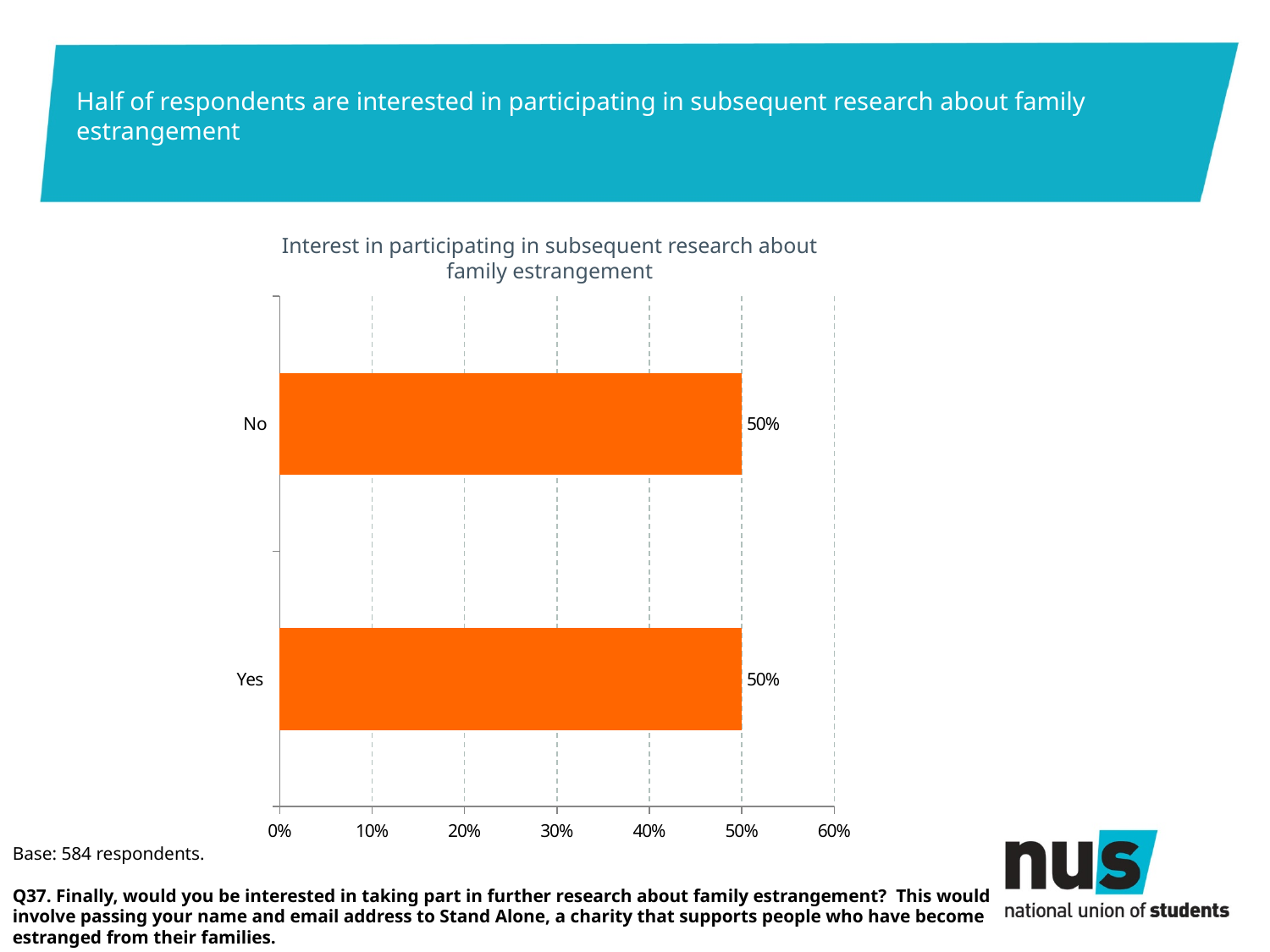
Is the value for "Yes" greater or less than 40%? greater What is the highest value shown on the x axis? 60% What kind of chart is shown on the slide? Bar chart What is the value for "No"? 50% What is the value for "Yes"? 50% What is the title of the chart? Interest in participating in subsequent research about family estrangement How many categories are shown on the chart? 2 What is the difference between the values for "No" and "Yes"? 0% Is the value for "No" greater or less than 60%? less What is the total of the values for "Yes" and "No"? 100% What colour are the bars in the chart? Orange